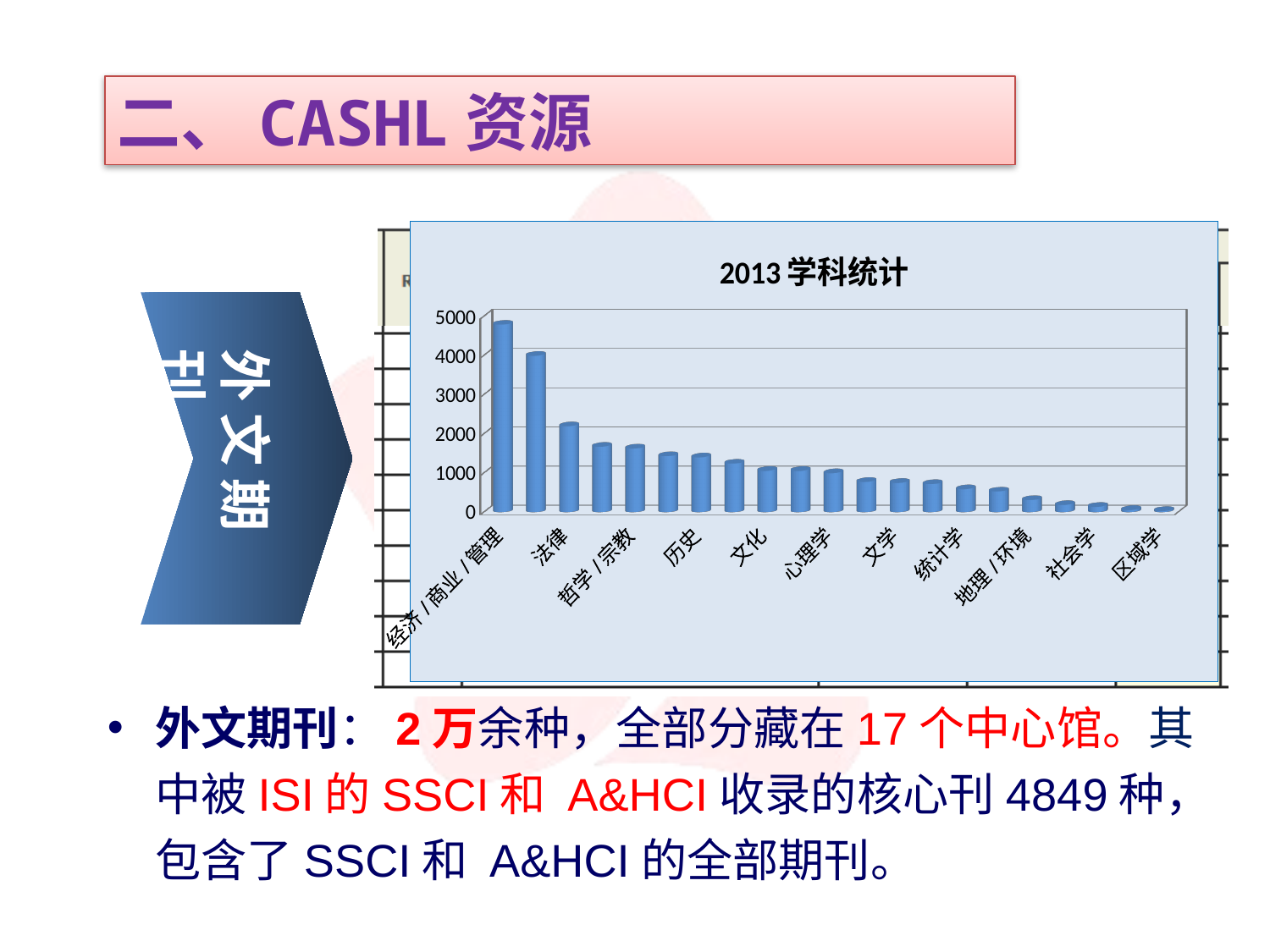
Which category has the highest value in the chart? 经济/商业/管理 What kind of chart is shown on the slide? bar chart Is the value for 地理/环境 greater or less than 1000? less Do the values rise or fall from left to right along the x axis? fall Is the value for 文学 greater or less than 1000? less Is the value for 哲学/宗教 greater or less than 2000? less What is the title of the chart? 2013 学科统计 Which has the larger value, 历史 or 统计学? 历史 Which has the larger value, 法律 or 哲学/宗教? 法律